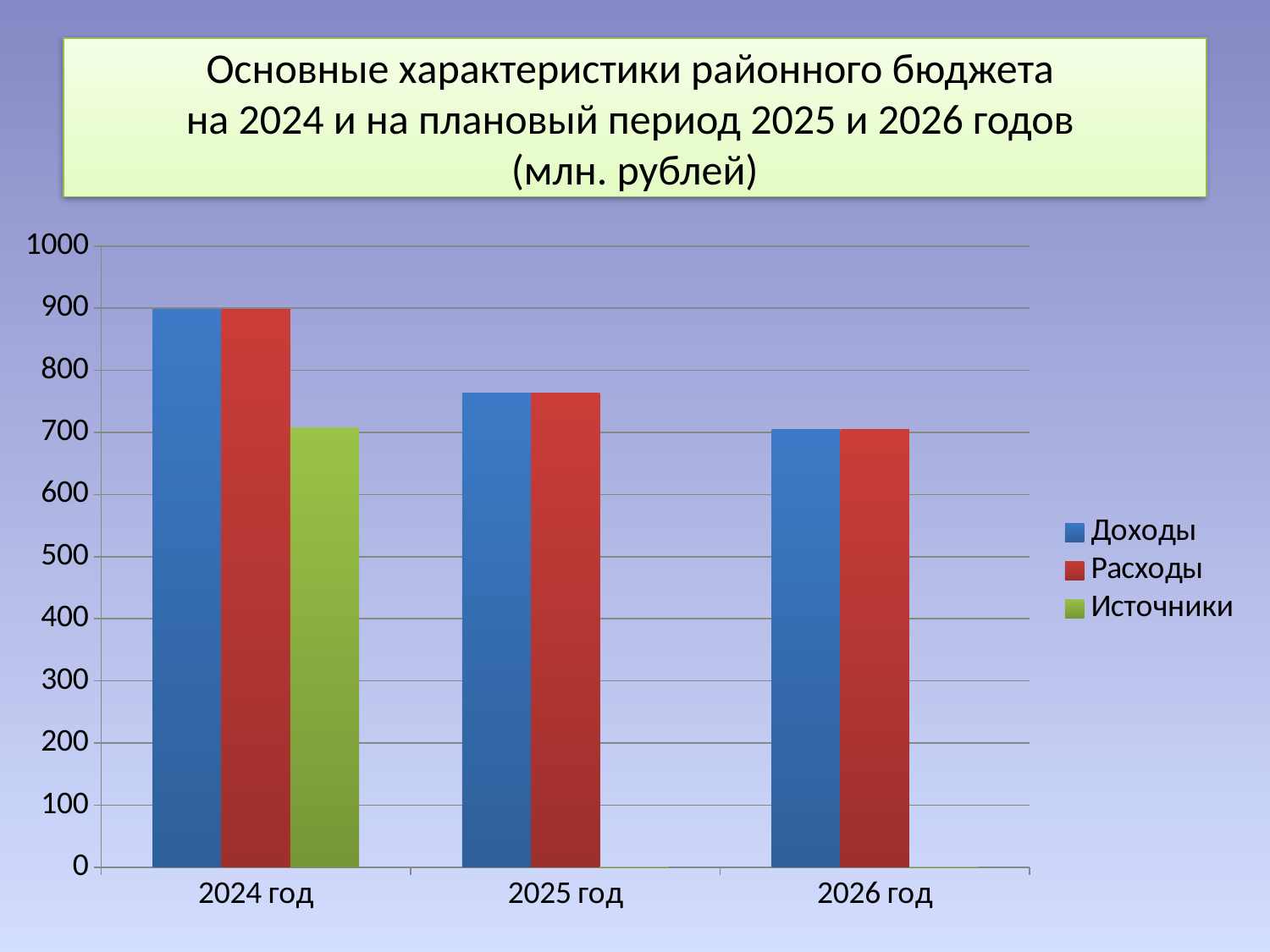
Is the value for Доходы in 2024 год greater or less than 800? greater What unit of measurement is stated in the chart title? млн. рублей Is the value for Источники in 2024 год greater or less than 600? greater How many series does the legend list? 3 How many year categories are shown on the x axis? 3 What kind of chart is shown on the slide? bar chart Which year has the lowest value for Расходы? 2026 год In 2024 год, which is larger: Доходы or Источники? Доходы Is the value for Расходы in 2025 год greater or less than 800? less Do the values for Доходы rise or fall from 2024 год to 2026 год? fall Which year has the highest value for Доходы? 2024 год